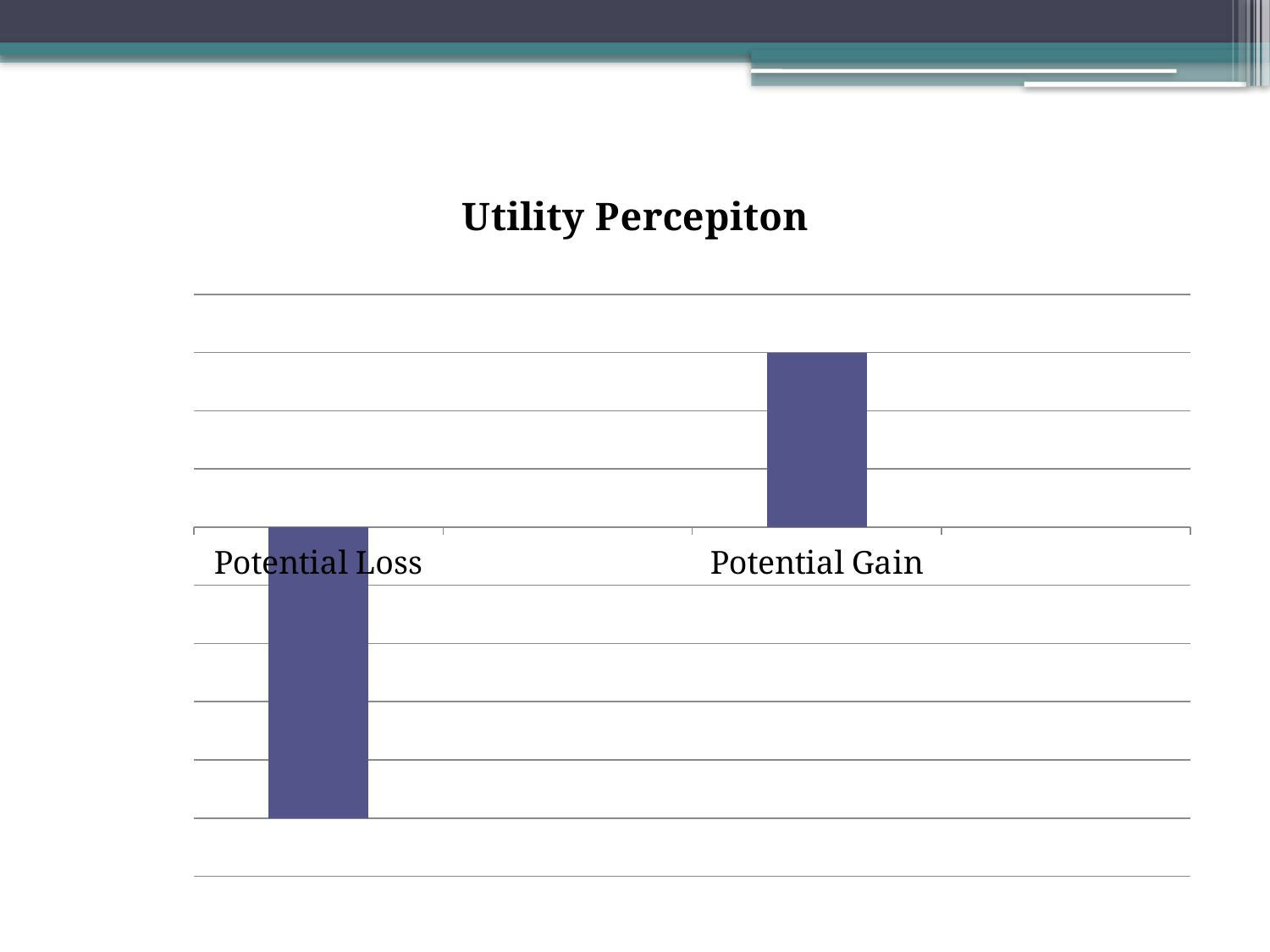
What kind of chart is shown on the slide? bar chart Do the values rise or fall moving from Potential Loss to Potential Gain along the x axis? rise Which category has the highest value in the chart? Potential Gain Which bar extends further from the zero line, Potential Loss or Potential Gain? Potential Loss How many categories are plotted in the chart? 2 Which is larger, the value for Potential Loss or the value for Potential Gain? Potential Gain What is the title of the chart? Utility Percepiton Which category has the lowest value in the chart? Potential Loss Which category has a negative value (its bar extends below the zero line)? Potential Loss